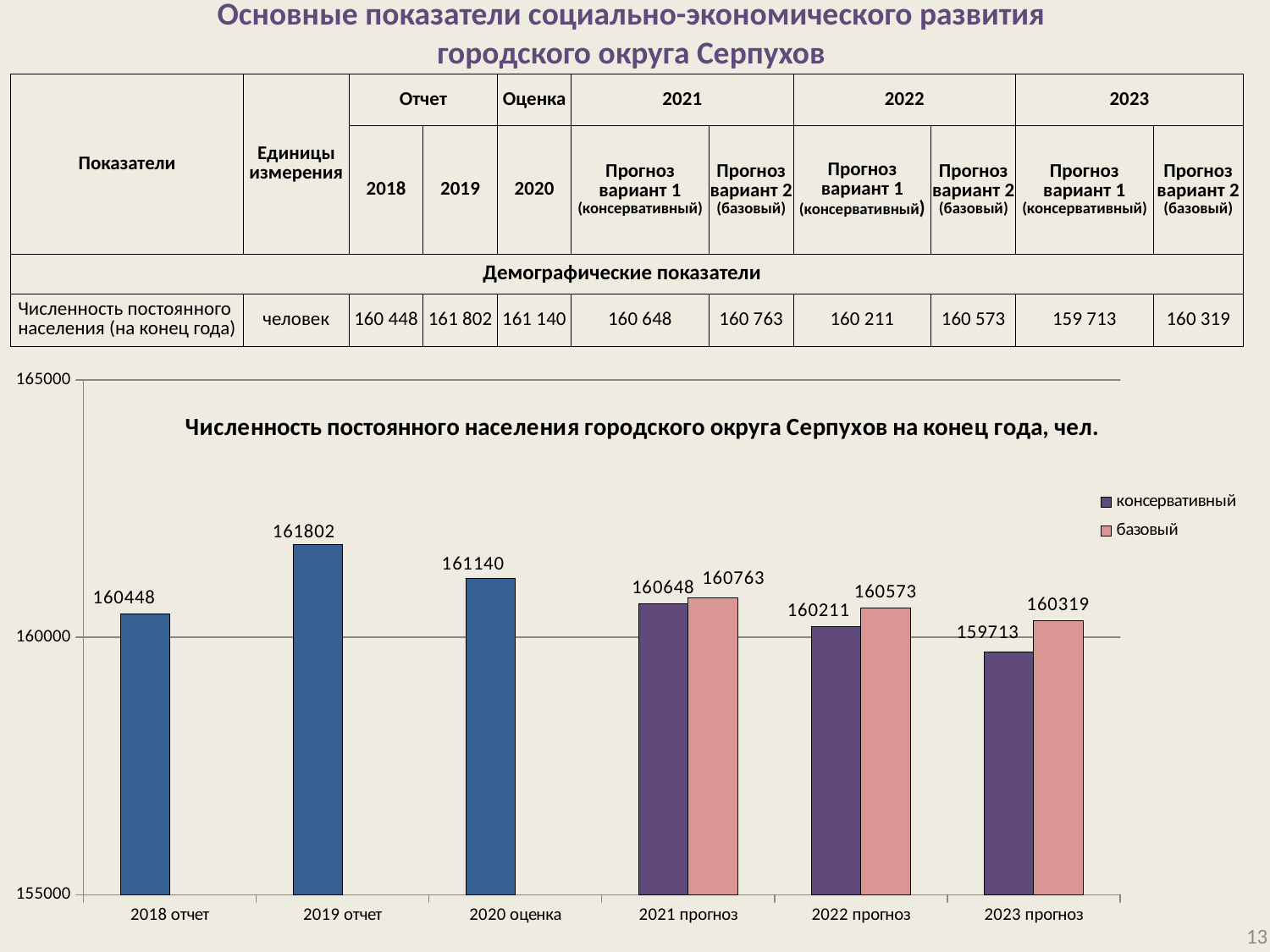
What is the difference between the базовый and консервативный values for 2022 прогноз? 362 What is the value of the базовый bar for 2023 прогноз? 160319 What is the difference between the values for 2019 отчет and 2020 оценка? 662 How many series does the chart legend list? 2 What is the value shown for 2018 отчет in the chart? 160448 Is the консервативный value for 2023 прогноз greater or less than 160000? less What type of chart is shown on the slide? bar chart Which is larger: the консервативный value for 2021 прогноз or the базовый value for 2021 прогноз? базовый (160763) What is the value of the консервативный bar for 2022 прогноз? 160211 Which bar in the chart has the lowest value? консервативный, 2023 прогноз (159713) Which category has the highest bar in the chart? 2019 отчет How many categories are shown on the x axis of the chart? 6